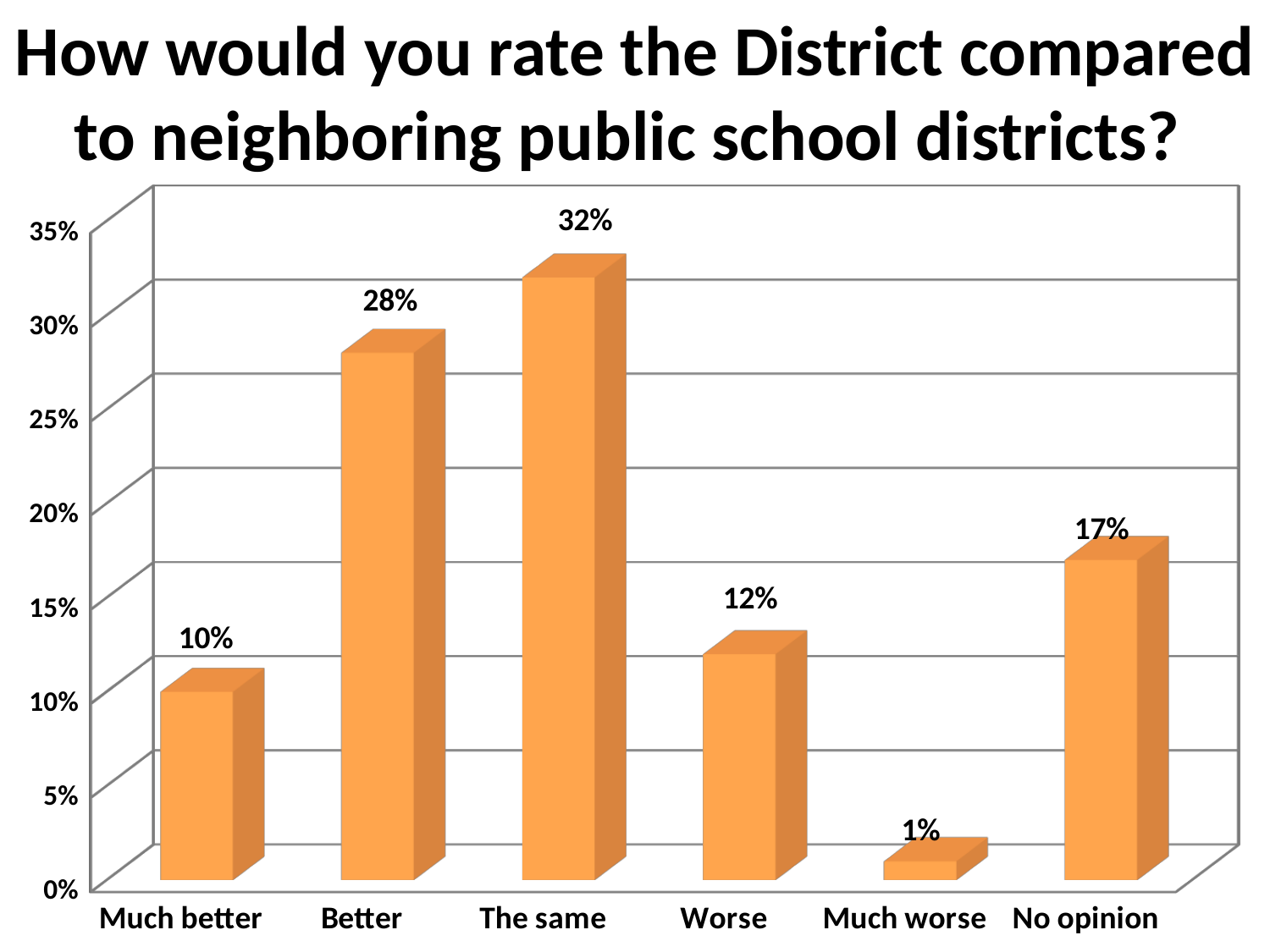
What is the value shown for "No opinion"? 17% What is the difference between the values for "Better" and "Much better"? 18% What is the difference between "The same" and "No opinion"? 15% What kind of chart is shown on the slide? Bar chart What percentage rated the District "Much worse"? 1% Is the value for "Better" greater or less than 25%? greater What is the title of the chart? How would you rate the District compared to neighboring public school districts? What percentage of respondents rated the District as "The same" compared to neighboring public school districts? 32% Which category has the highest value? The same How many categories are shown on the x axis? 6 Which is larger, the value for "Worse" or the value for "No opinion"? No opinion Which category has the lowest value? Much worse